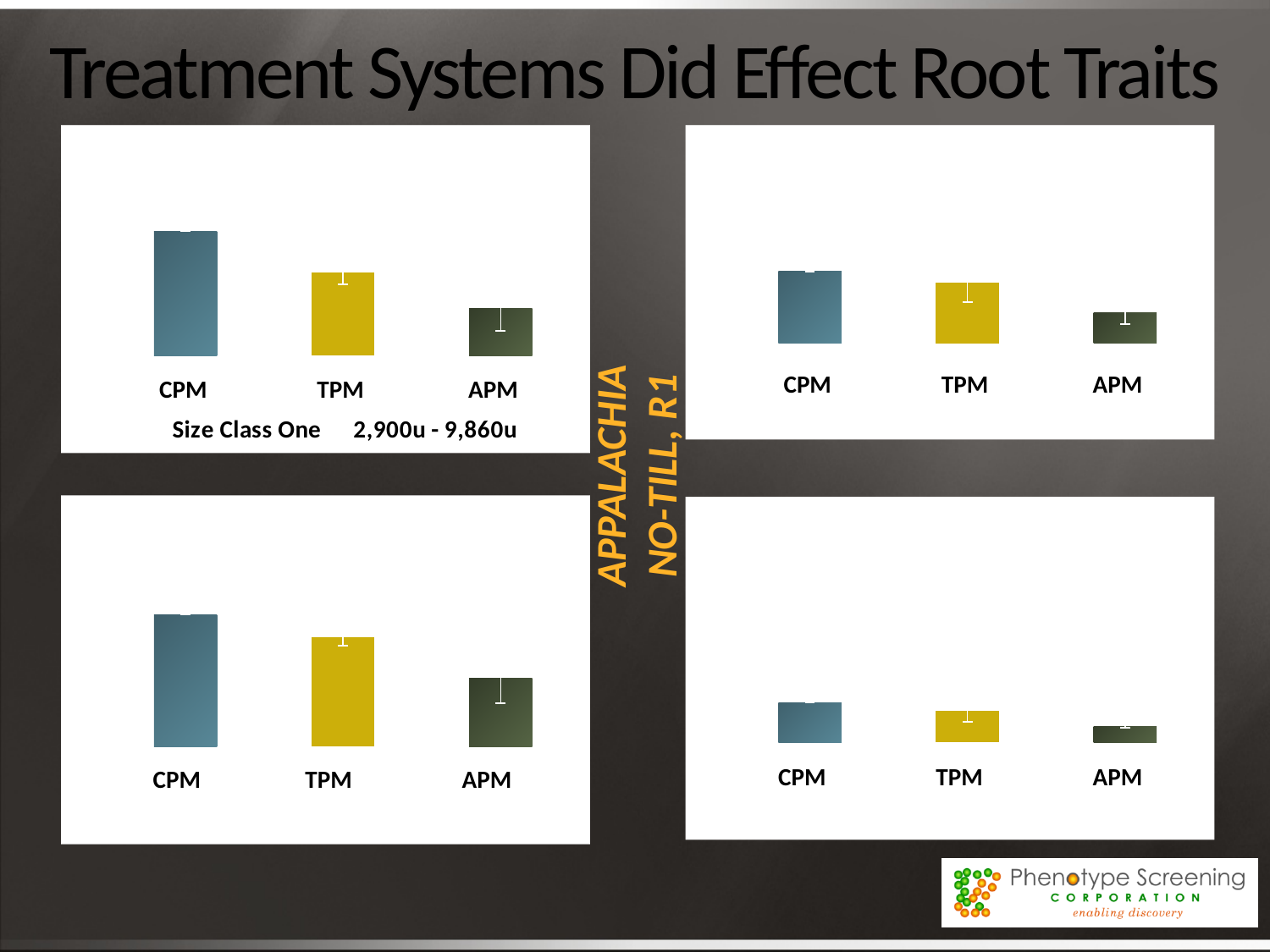
How many categories are shown in the top-left chart? 3 In the bottom-left chart, is the bar for CPM taller or shorter than the bar for TPM? taller How many bar charts are shown on the slide? 4 What kind of chart is the top-right chart? bar chart In the top-left chart, which category has the shortest bar? APM In the top-right chart, which category has the tallest bar? CPM In the top-left chart, which category has the tallest bar? CPM In the top-left chart, do the bars rise or fall from CPM to APM? fall In the bottom-left chart, which category has the shortest bar? APM In the bottom-right chart, which category has the tallest bar? CPM What size class and range is labelled under the top-left chart? Size Class One 2,900u - 9,860u In the bottom-right chart, is the bar for TPM taller or shorter than the bar for APM? taller